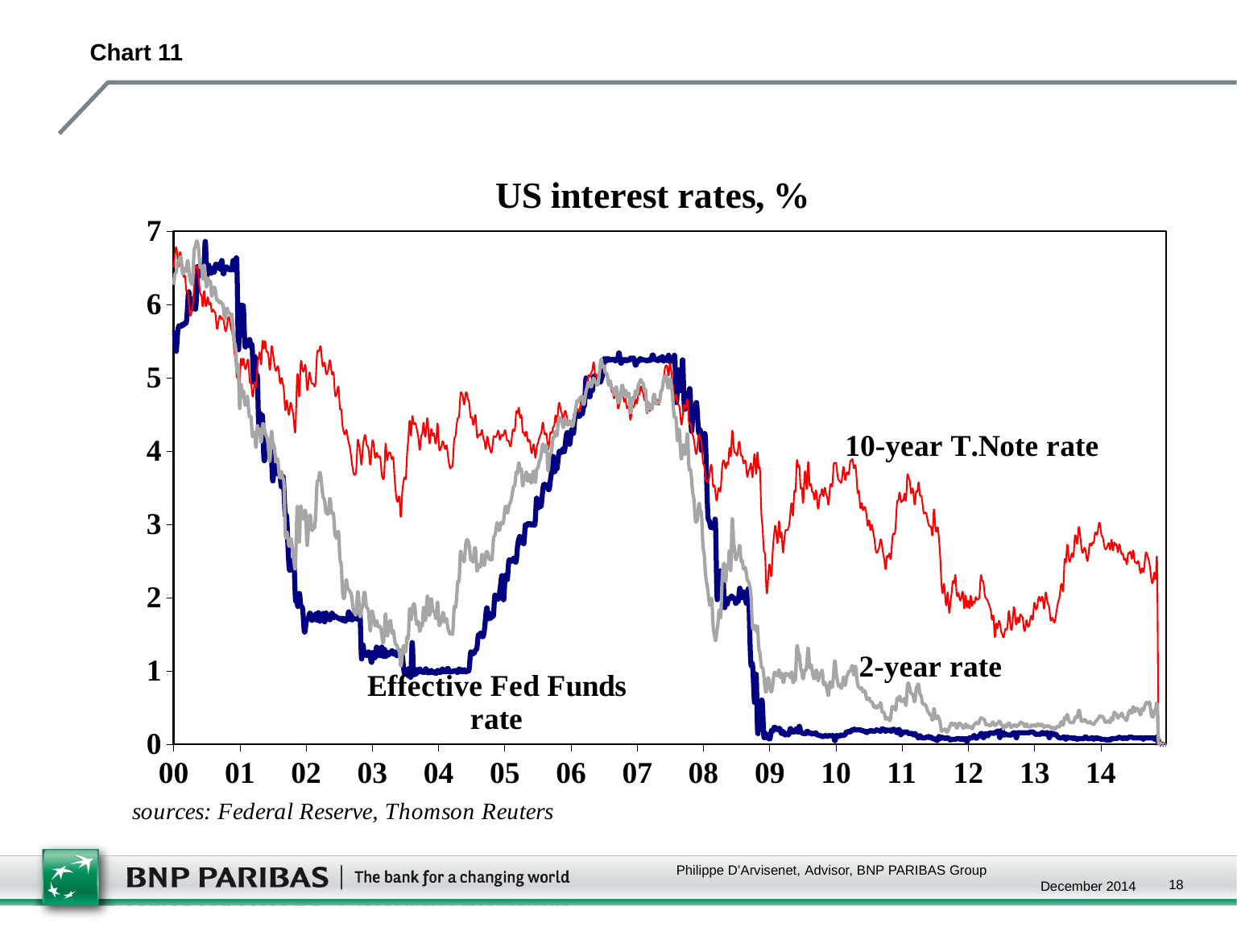
What is the title of the chart? US interest rates, % Which series is drawn in red? 10-year T.Note rate Is the value of the Effective Fed Funds rate in 2013 greater or less than 1? less How many series are plotted on the chart? 3 Is the value of the Effective Fed Funds rate in early 2007 greater or less than 4? greater In 2012, which is higher, the 10-year T.Note rate or the 2-year rate? 10-year T.Note rate Does the Effective Fed Funds rate rise or fall between 2004 and 2006? rise Does the Effective Fed Funds rate rise or fall between 2007 and 2009? fall Is the value of the 2-year rate in 2012 greater or less than 1? less How many year labels are shown on the x axis? 15 What kind of chart is shown on the slide? line chart